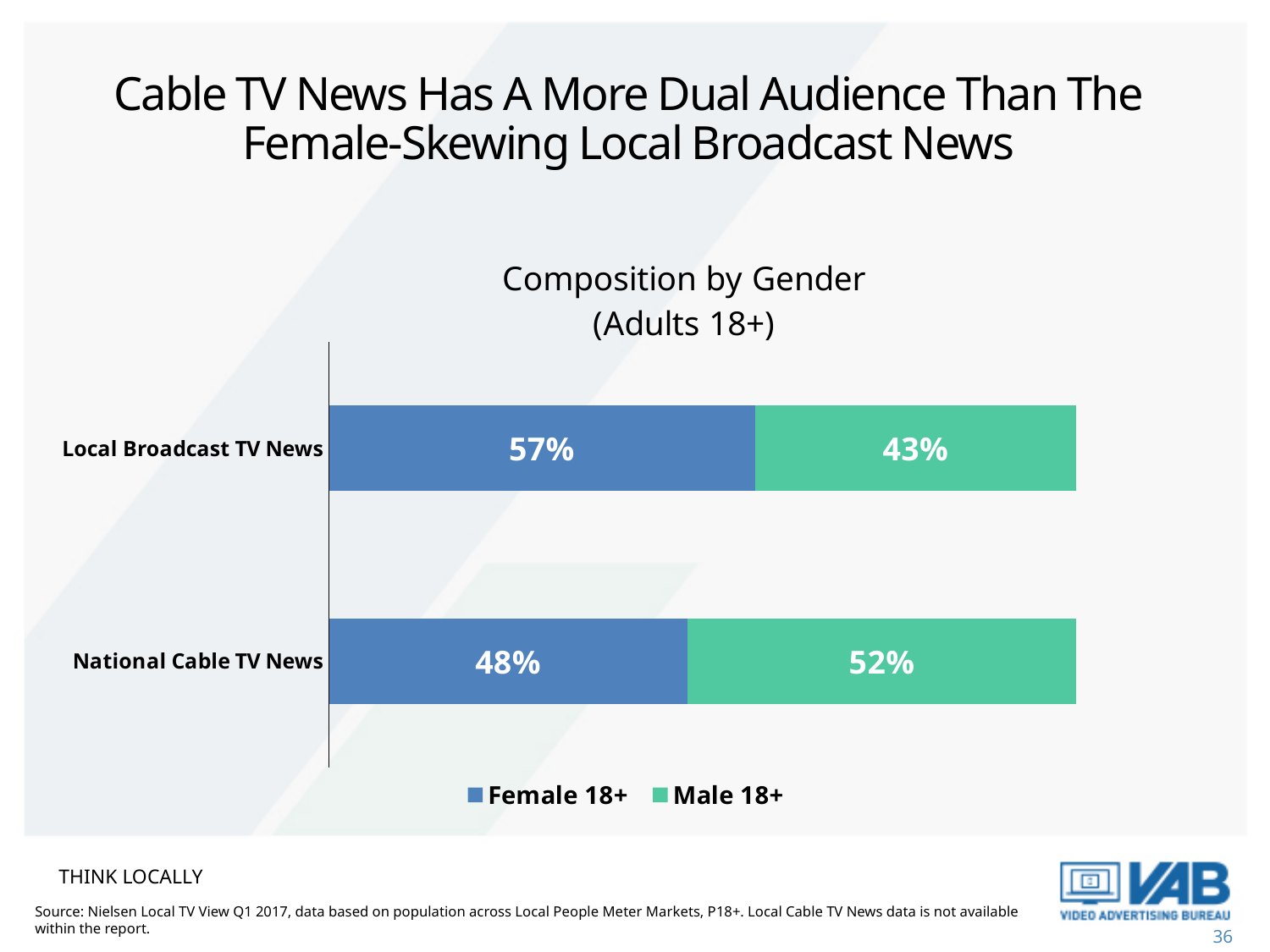
Which category has the higher Female 18+ share? Local Broadcast TV News What kind of chart is shown? Stacked bar chart What is the Female 18+ share for Local Broadcast TV News? 57% How many series does the legend list? 2 What is the Male 18+ share for National Cable TV News? 52% What is the difference between the Female 18+ and Male 18+ shares for Local Broadcast TV News? 14% What is the Male 18+ share for Local Broadcast TV News? 43% For National Cable TV News, which is larger: the Female 18+ share or the Male 18+ share? Male 18+ How many categories are shown on the chart? 2 What is the Female 18+ share for National Cable TV News? 48% Which category has the lower Male 18+ share? Local Broadcast TV News What is the title of the chart? Composition by Gender (Adults 18+)